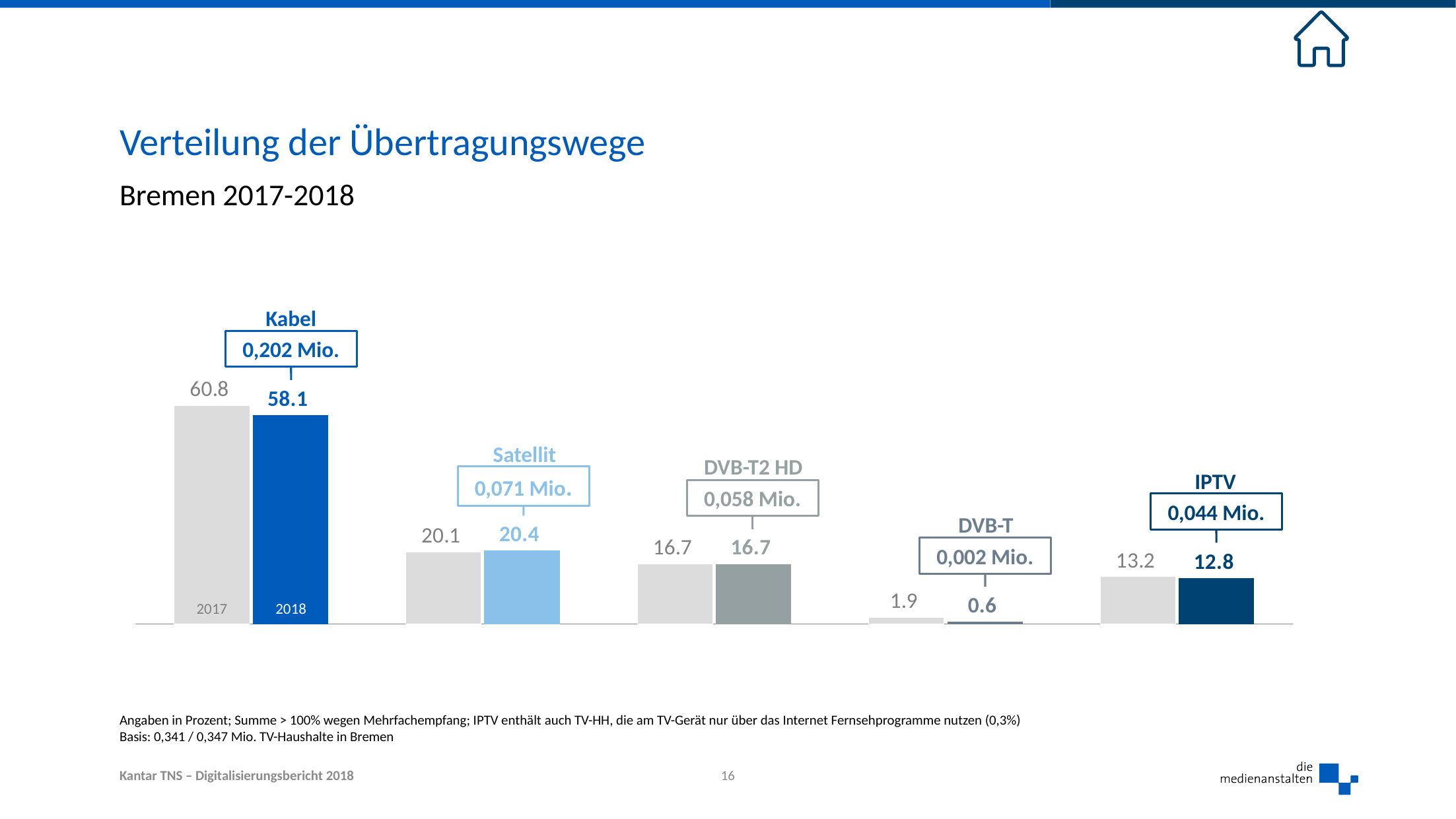
Which transmission path has the highest 2018 value? Kabel What number of households in millions is shown in the box above IPTV? 0,044 Mio. What kind of chart is shown on the slide? Bar chart What is the 2018 value for DVB-T? 0.6 What is the 2017 value for Satellit? 20.1 What is the 2017 value for IPTV? 13.2 Which is larger: the 2018 value for Satellit or the 2018 value for DVB-T2 HD? Satellit How many transmission paths are shown in the chart? 5 Which transmission path has the lowest 2017 value? DVB-T By how much did the Kabel value fall from 2017 to 2018? 2.7 Which two years are compared in the chart? 2017 and 2018 What is the 2018 value for Kabel? 58.1